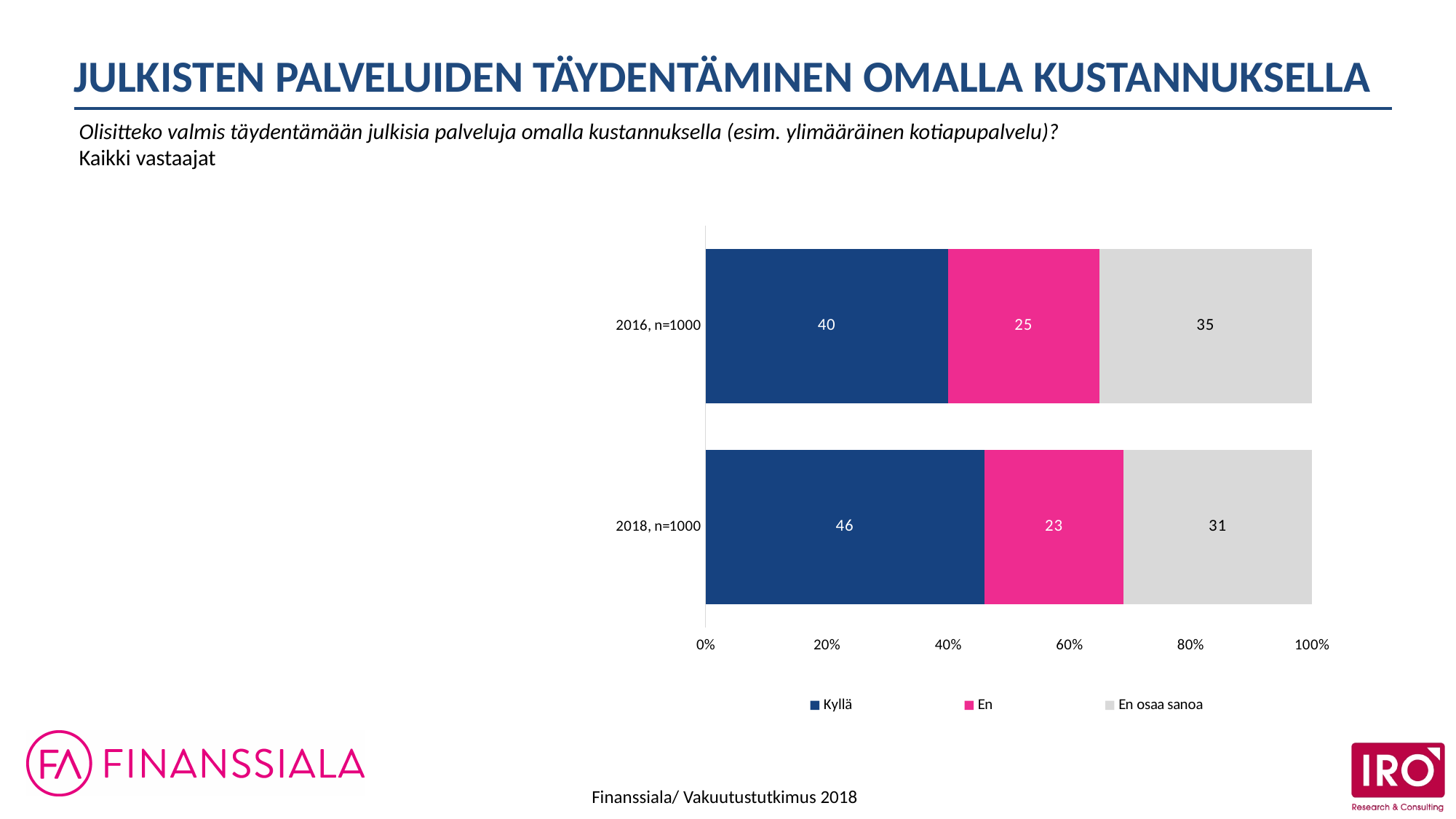
What is the value for En in 2016, n=1000? 25 What is the difference between the En osaa sanoa values for 2016, n=1000 and 2018, n=1000? 4 What is the value for En osaa sanoa in 2018, n=1000? 31 What is the value for Kyllä in 2016, n=1000? 40 Which series is the lowest value in 2018, n=1000? En How many series does the legend list? 3 What is the difference between the Kyllä values for 2018, n=1000 and 2016, n=1000? 6 What is the total of the stacked bar for 2018, n=1000? 100 How many categories are shown on the chart? 2 Which category has the higher Kyllä value, 2016, n=1000 or 2018, n=1000? 2018, n=1000 Which colour represents the En series in the legend? Pink What kind of chart is shown on the slide? Stacked bar chart